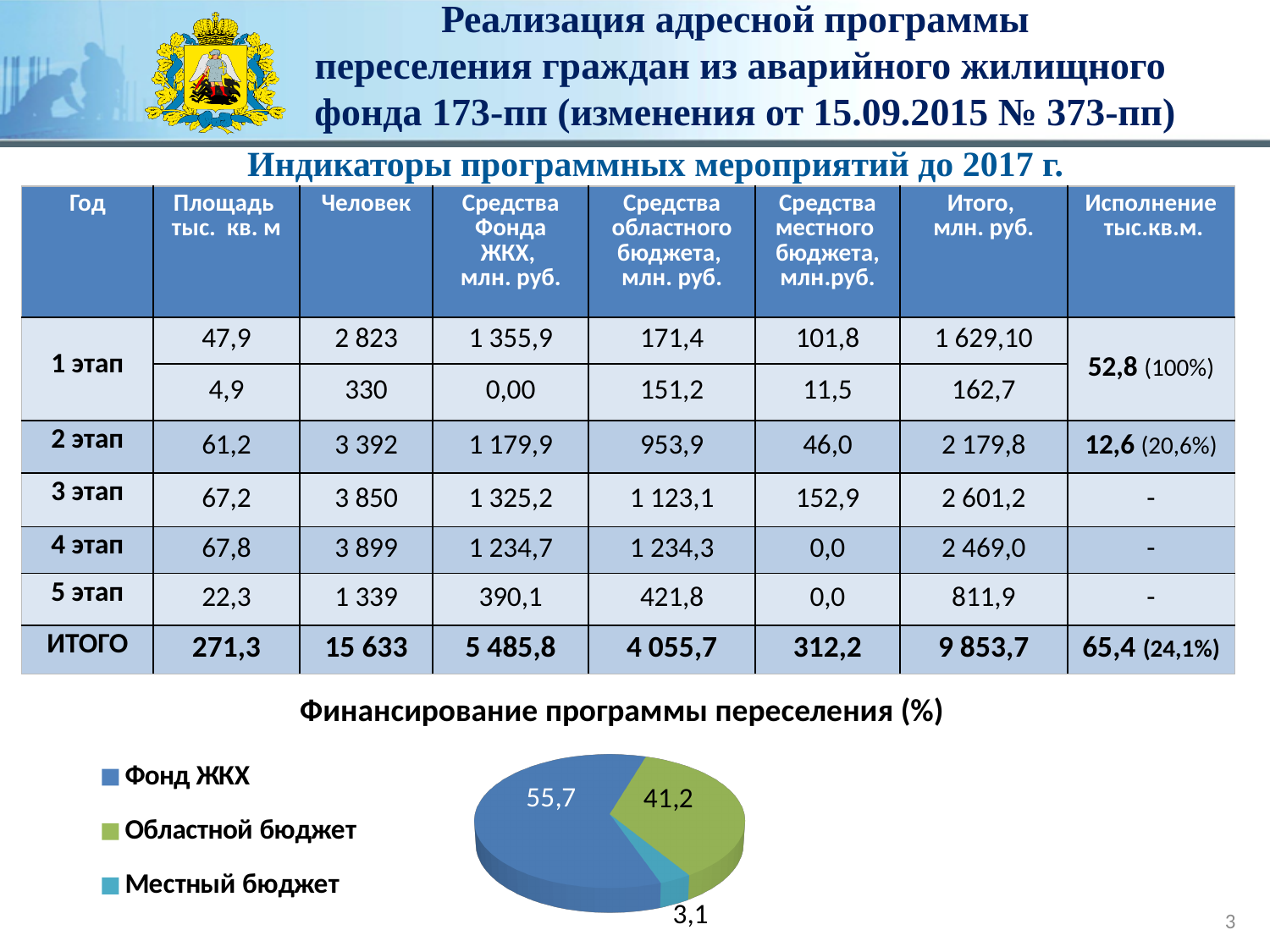
In the pie chart "Финансирование программы переселения (%)", which is larger: Областной бюджет or Местный бюджет? Областной бюджет In the pie chart "Финансирование программы переселения (%)", which category has the largest slice? Фонд ЖКХ In the pie chart "Финансирование программы переселения (%)", what colour is the slice for Областной бюджет? green In the pie chart "Финансирование программы переселения (%)", which category has the smallest slice? Местный бюджет What type of chart is shown under the title "Финансирование программы переселения (%)"? pie chart In the pie chart "Финансирование программы переселения (%)", what is the value for Областной бюджет? 41,2 In the pie chart "Финансирование программы переселения (%)", what is the value for Фонд ЖКХ? 55,7 How many slices does the pie chart "Финансирование программы переселения (%)" have? 3 In the pie chart "Финансирование программы переселения (%)", what is the value for Местный бюджет? 3,1 How many entries does the legend of the pie chart "Финансирование программы переселения (%)" list? 3 In the pie chart "Финансирование программы переселения (%)", what is the difference between the values for Фонд ЖКХ and Областной бюджет? 14,5 What is the title of the pie chart on the slide? Финансирование программы переселения (%)